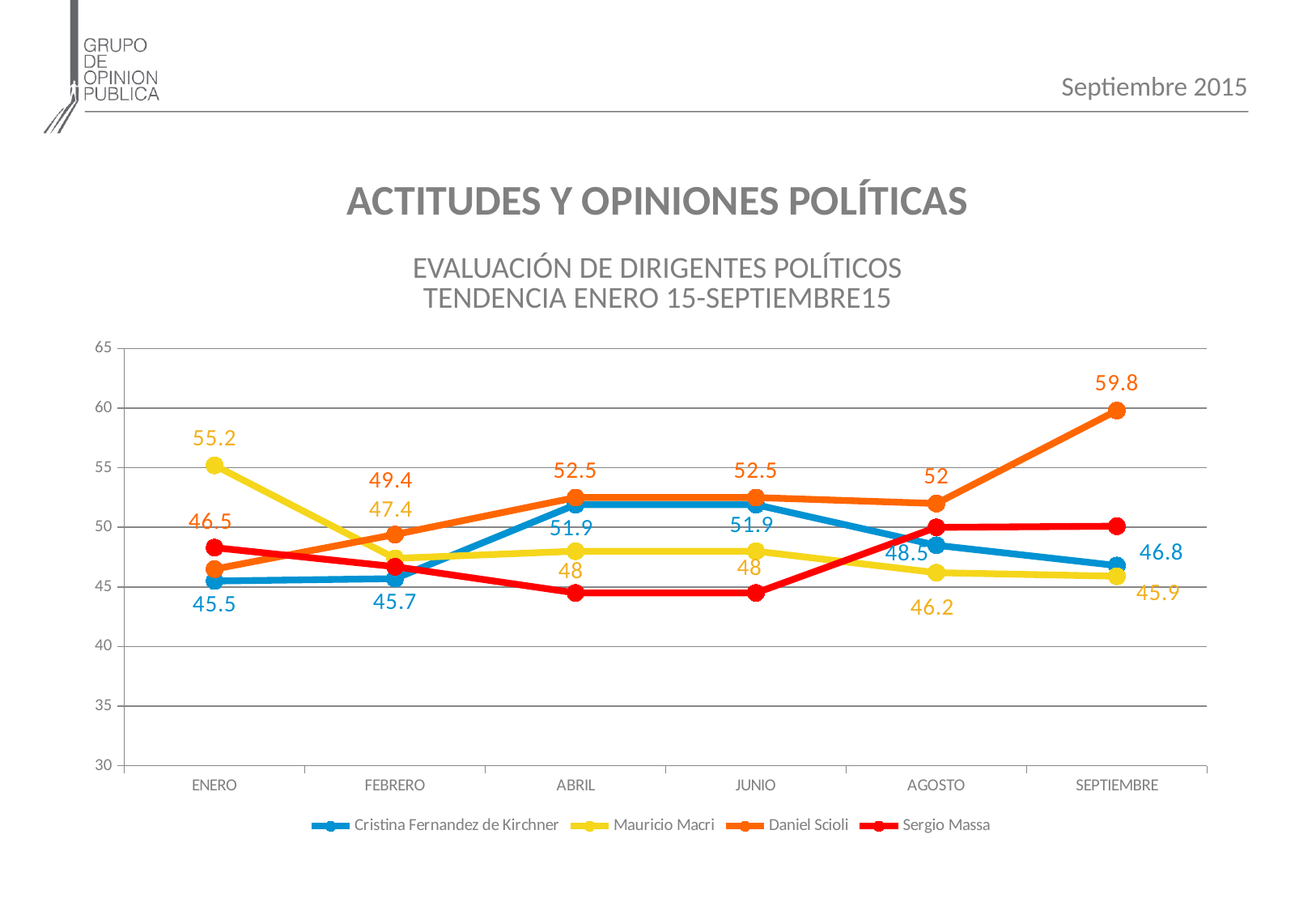
How many months are shown on the x axis? 6 What is the value for Mauricio Macri in Enero? 55.2 What is the value for Cristina Fernandez de Kirchner in Agosto? 48.5 What is the difference between Daniel Scioli's values in Septiembre and Agosto? 7.8 What kind of chart is shown on the slide? line chart In Abril, who has the higher value: Cristina Fernandez de Kirchner or Mauricio Macri? Cristina Fernandez de Kirchner Is the value for Sergio Massa in Junio greater or less than 50? less In which month does Mauricio Macri have his lowest value? Septiembre How many series does the legend list? 4 Does Daniel Scioli's line rise or fall from Agosto to Septiembre? rise What is the value for Daniel Scioli in Septiembre? 59.8 In which month does Daniel Scioli reach his highest value? Septiembre